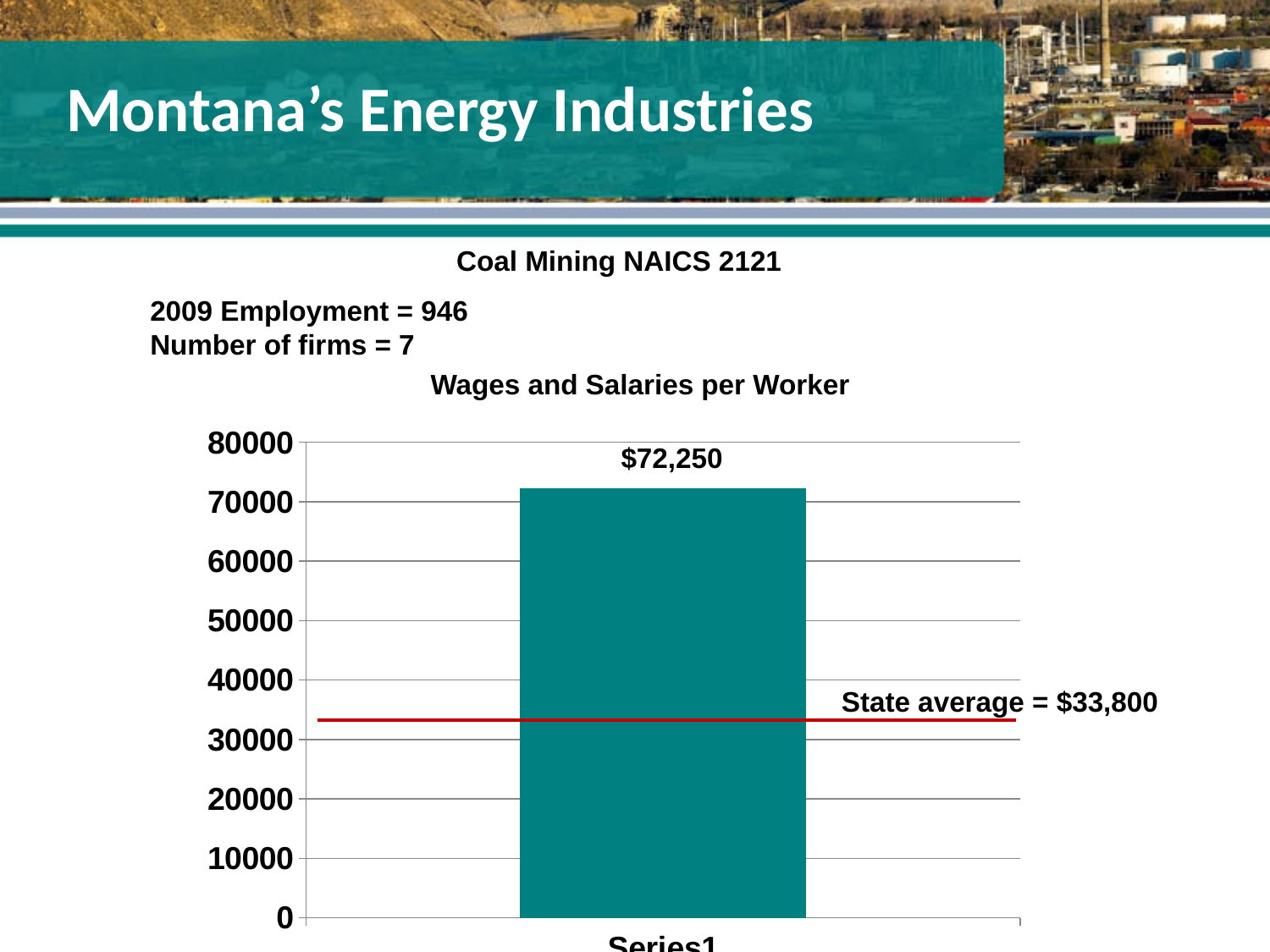
What is the maximum value shown on the vertical axis of the chart? 80000 What state average value is marked by the red line on the chart? $33,800 What is the difference between the coal mining wages per worker and the state average shown on the chart? $38,450 What is the title of the chart? Wages and Salaries per Worker What is the 2009 employment figure stated above the chart for Coal Mining NAICS 2121? 946 Which is larger: the coal mining wages per worker bar or the state average line? Coal mining wages per worker How many bars are plotted in the chart? 1 What kind of chart is shown on the slide? Bar chart Is the value of the bar greater or less than 70000? greater How many firms are stated above the chart for Coal Mining NAICS 2121? 7 What is the value of the bar in the Wages and Salaries per Worker chart? $72,250 Is the state average line greater or less than 40000? less